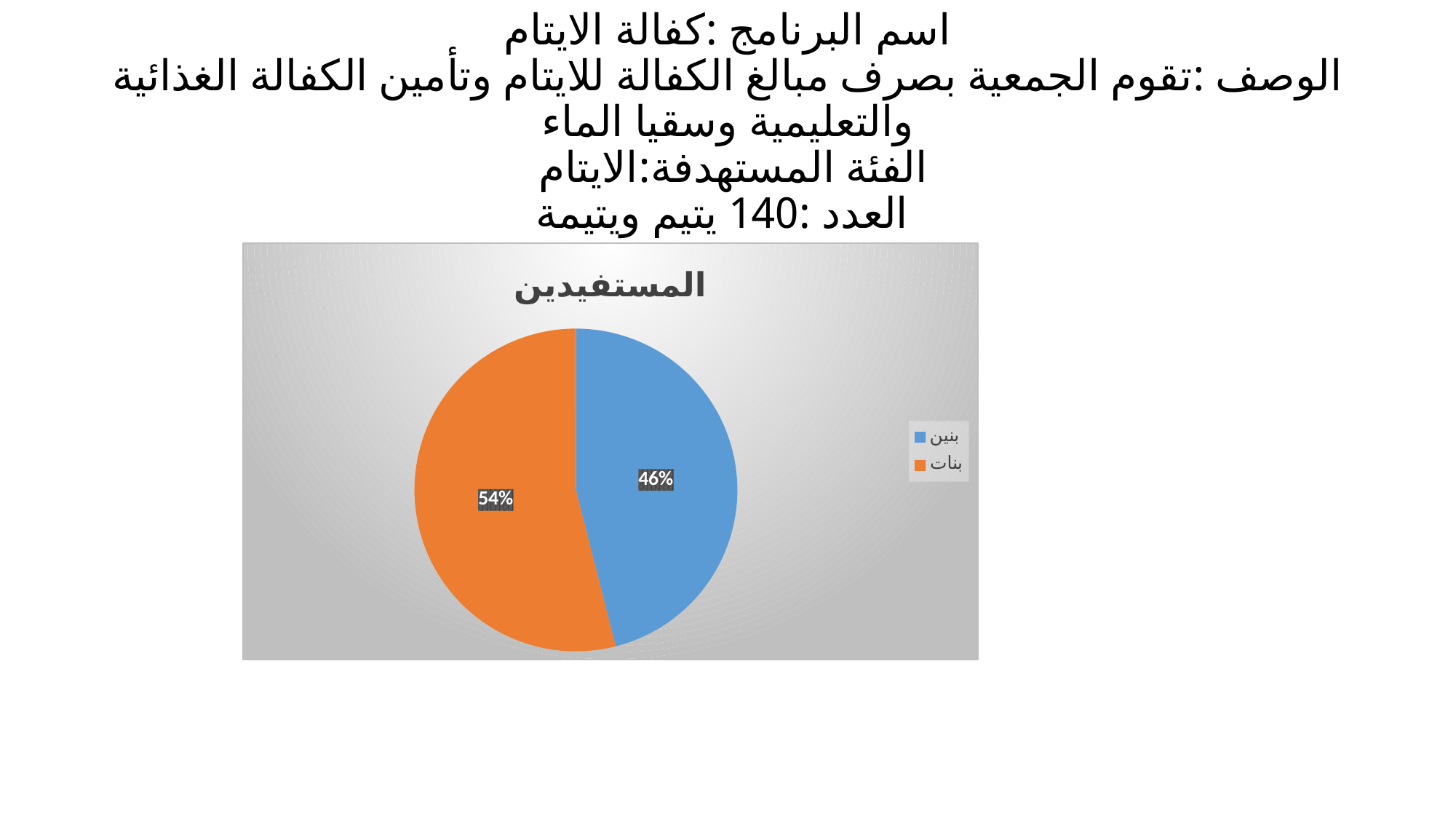
What share of the pie does بنين represent? 46% What type of chart is shown on the slide? pie chart How many entries does the legend list? 2 Which is larger, the share for بنين or the share for بنات? بنات Is the share for بنين greater or less than 50%? less What is the difference in percentage points between the بنات slice and the بنين slice? 8 What share of the pie does بنات represent? 54% What is the title of the chart? المستفيدين How many slices does the pie chart have? 2 Which category has the largest slice of the pie? بنات What colour is the slice for بنات? orange Which category has the smallest slice of the pie? بنين